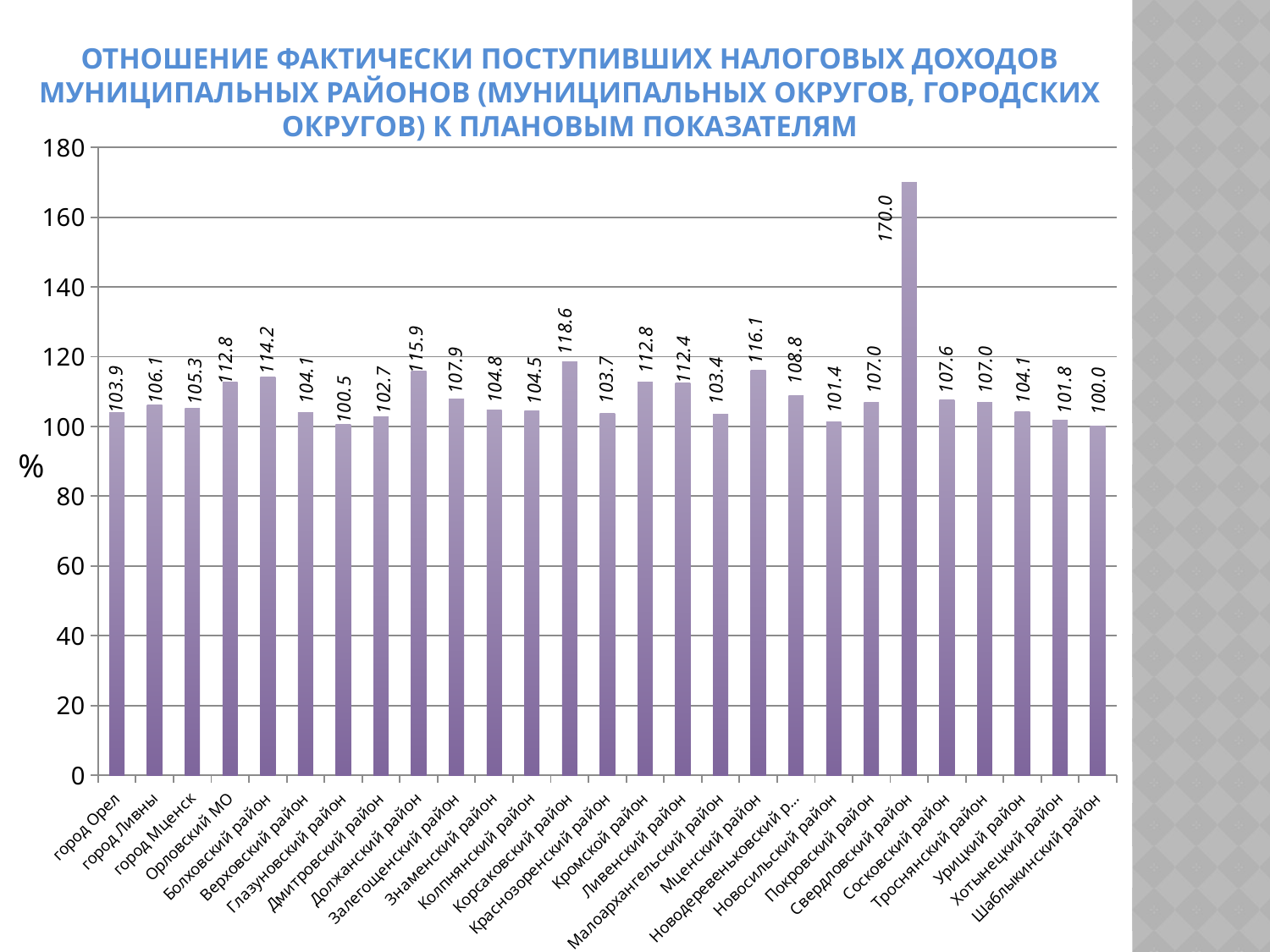
How many categories are shown on the x axis? 27 Is the value for Свердловский район greater or less than 160? greater What is the difference between the values for Свердловский район and Шаблыкинский район? 70.0 What is the value for Корсаковский район? 118.6 What kind of chart is shown on the slide? bar chart Which is larger, the value for Болховский район or the value for Должанский район? Должанский район What is the value for Новодеревеньковский район? 108.8 What is the difference between the values for Корсаковский район and Мценский район? 2.5 Which category has the highest value? Свердловский район What is the value for Свердловский район? 170.0 What is the value for город Орел? 103.9 Which category has the lowest value? Шаблыкинский район